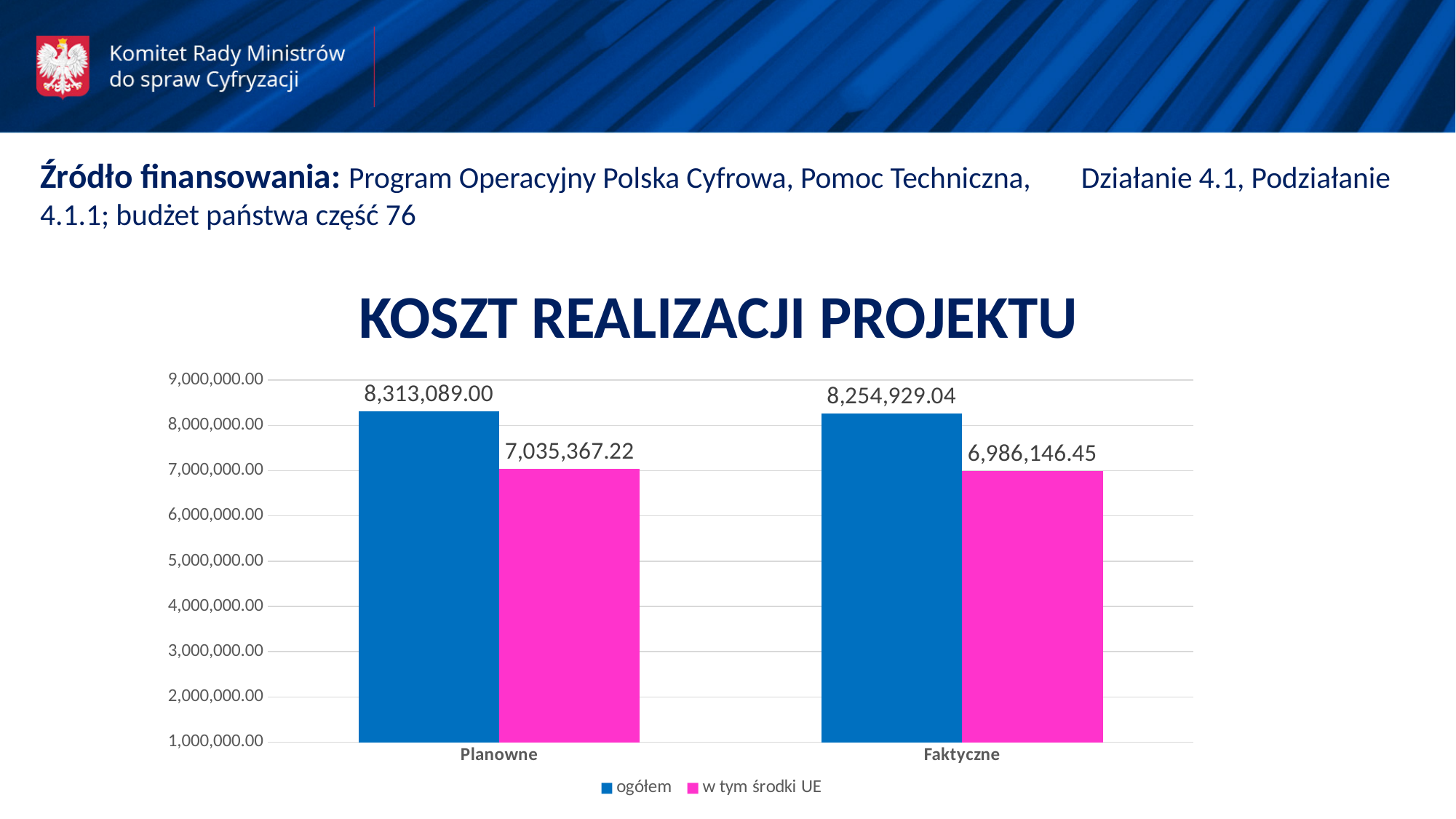
What is the value of 'w tym środki UE' for Planowne? 7,035,367.22 What type of chart is shown on the slide? bar chart Which is larger: 'w tym środki UE' for Planowne or for Faktyczne? Planowne How many series does the legend list? 2 How many categories are shown on the x axis? 2 Which bar has the highest value in the chart? ogółem, Planowne What is the difference between the 'ogółem' values for Planowne and Faktyczne? 58,159.96 What is the value of 'ogółem' for Faktyczne? 8,254,929.04 What is the value of 'w tym środki UE' for Faktyczne? 6,986,146.45 What is the title of the chart? KOSZT REALIZACJI PROJEKTU What is the value of 'ogółem' for Planowne? 8,313,089.00 Which bar has the lowest value in the chart? w tym środki UE, Faktyczne